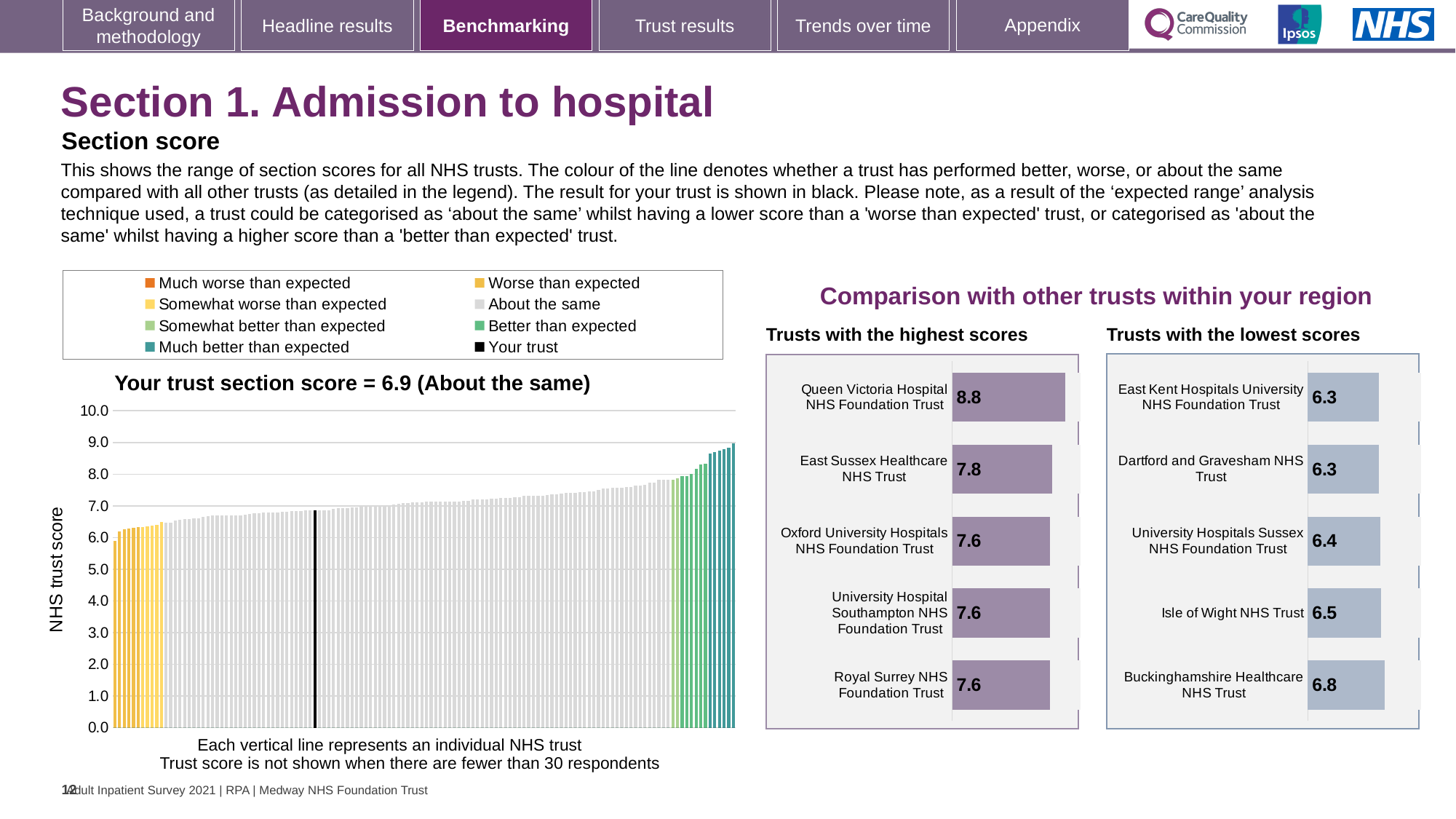
How many trusts are shown in the 'Trusts with the highest scores' chart? 5 According to the title of the left chart, what is your trust's section score? 6.9 In the 'Trusts with the highest scores' chart, which trust has the highest score? Queen Victoria Hospital NHS Foundation Trust In the 'Trusts with the lowest scores' chart, what is the score for Buckinghamshire Healthcare NHS Trust? 6.8 In the 'Trusts with the lowest scores' chart, what is the difference between the scores of Buckinghamshire Healthcare NHS Trust and East Kent Hospitals University NHS Foundation Trust? 0.5 In the 'Trusts with the lowest scores' chart, which has the larger score: Isle of Wight NHS Trust or University Hospitals Sussex NHS Foundation Trust? Isle of Wight NHS Trust What kind of chart is the 'Your trust section score' chart on the left? Bar chart In the 'Trusts with the highest scores' chart, what is the difference between the scores of Queen Victoria Hospital NHS Foundation Trust and East Sussex Healthcare NHS Trust? 1.0 In the 'Trusts with the highest scores' chart, what is the score for Queen Victoria Hospital NHS Foundation Trust? 8.8 How many entries does the legend above the left chart list? 8 In the left chart, is the tallest bar greater or less than 8.0? greater In the 'Trusts with the lowest scores' chart, which trust has the highest score? Buckinghamshire Healthcare NHS Trust